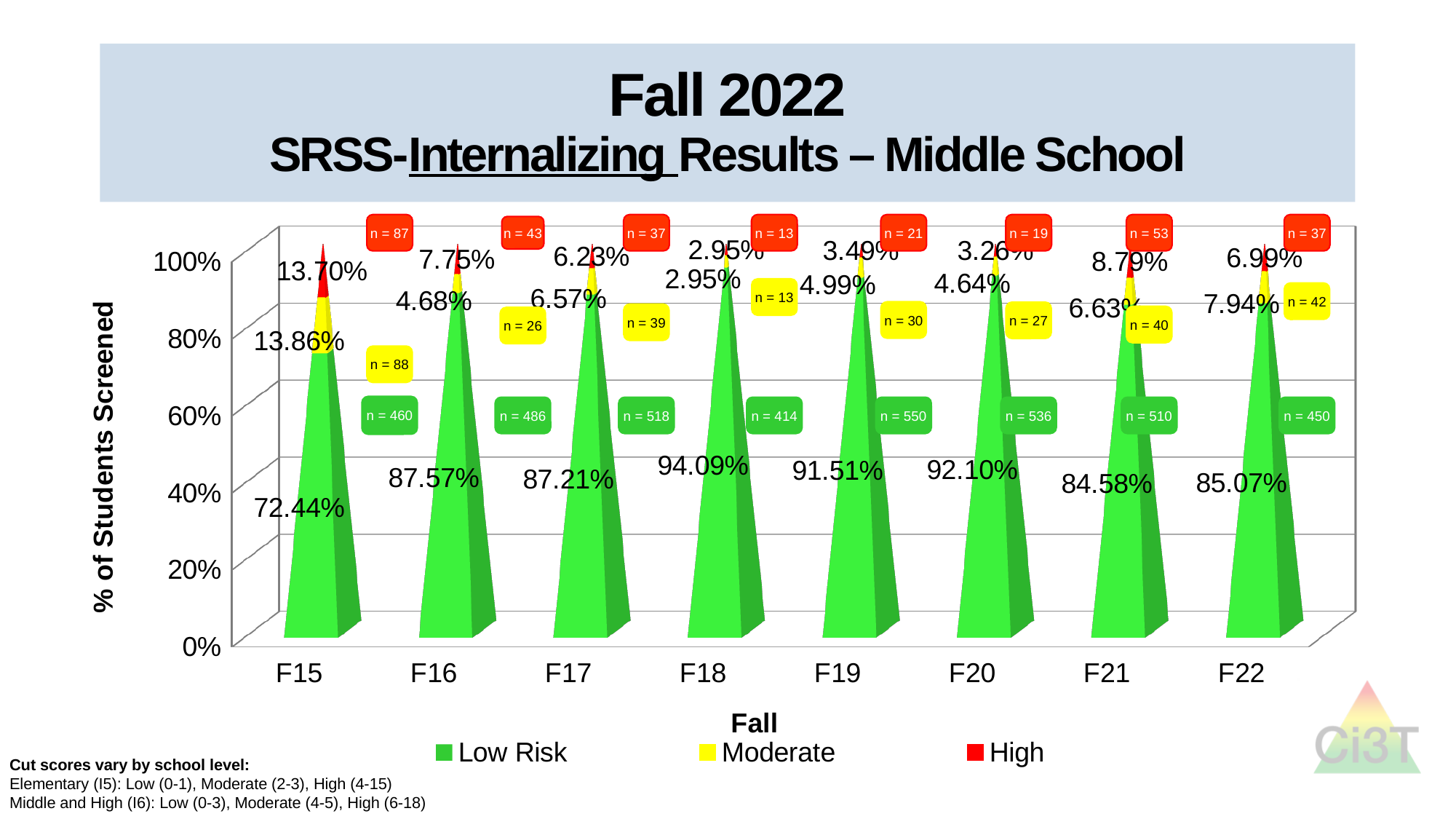
What percentage of students were in the Moderate category in F22? 7.94% How many fall semesters are shown on the x axis? 8 Which fall has the highest Low Risk percentage? F18 How many series does the legend list? 3 Which fall has the lowest Low Risk percentage? F15 What percentage of students were Low Risk in F18? 94.09% What percentage of students were in the High category in F21? 8.79% What colour represents the Moderate category in the legend? Yellow What is the difference between the Low Risk percentage in F16 and in F15? 15.13% What percentage of students were Low Risk in F15? 72.44% Which is larger, the Low Risk percentage in F19 or in F21? F19 What kind of chart is shown on the slide? Stacked bar chart